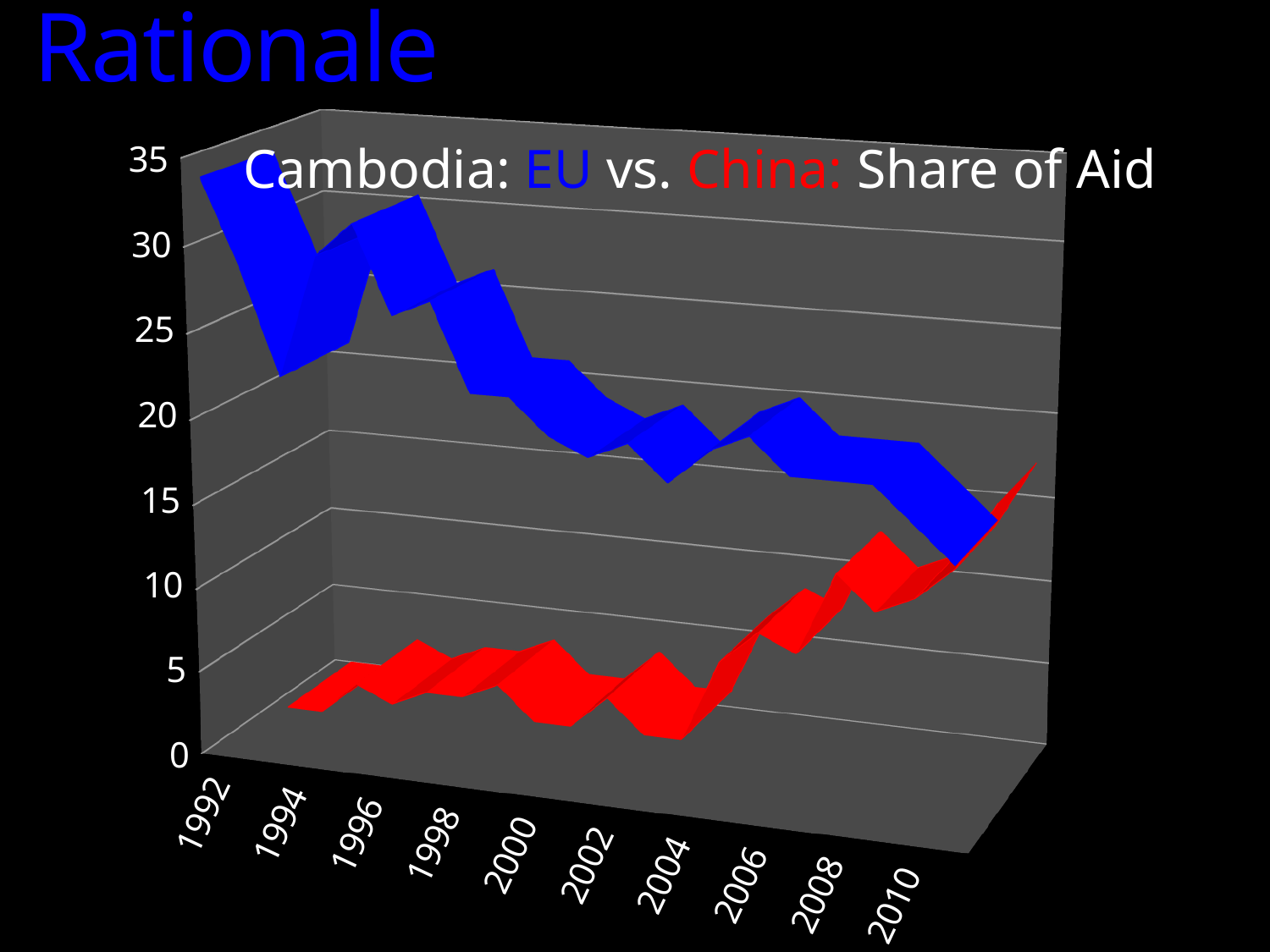
How many series does the chart show? 2 Is the EU value for 2010 greater or less than 20? less Does the EU share of aid rise or fall from 1992 to 2010? fall In 1996, which series has the larger share of aid, EU or China? EU Is the China value for 2010 greater or less than 10? greater What kind of chart is shown on the slide? line chart Is the China value for 1996 greater or less than 10? less How many year labels are shown on the x axis? 10 Does the China share of aid rise or fall from 2004 to 2010? rise What is the title of the chart? Cambodia: EU vs. China: Share of Aid Which colour represents China in the chart? red